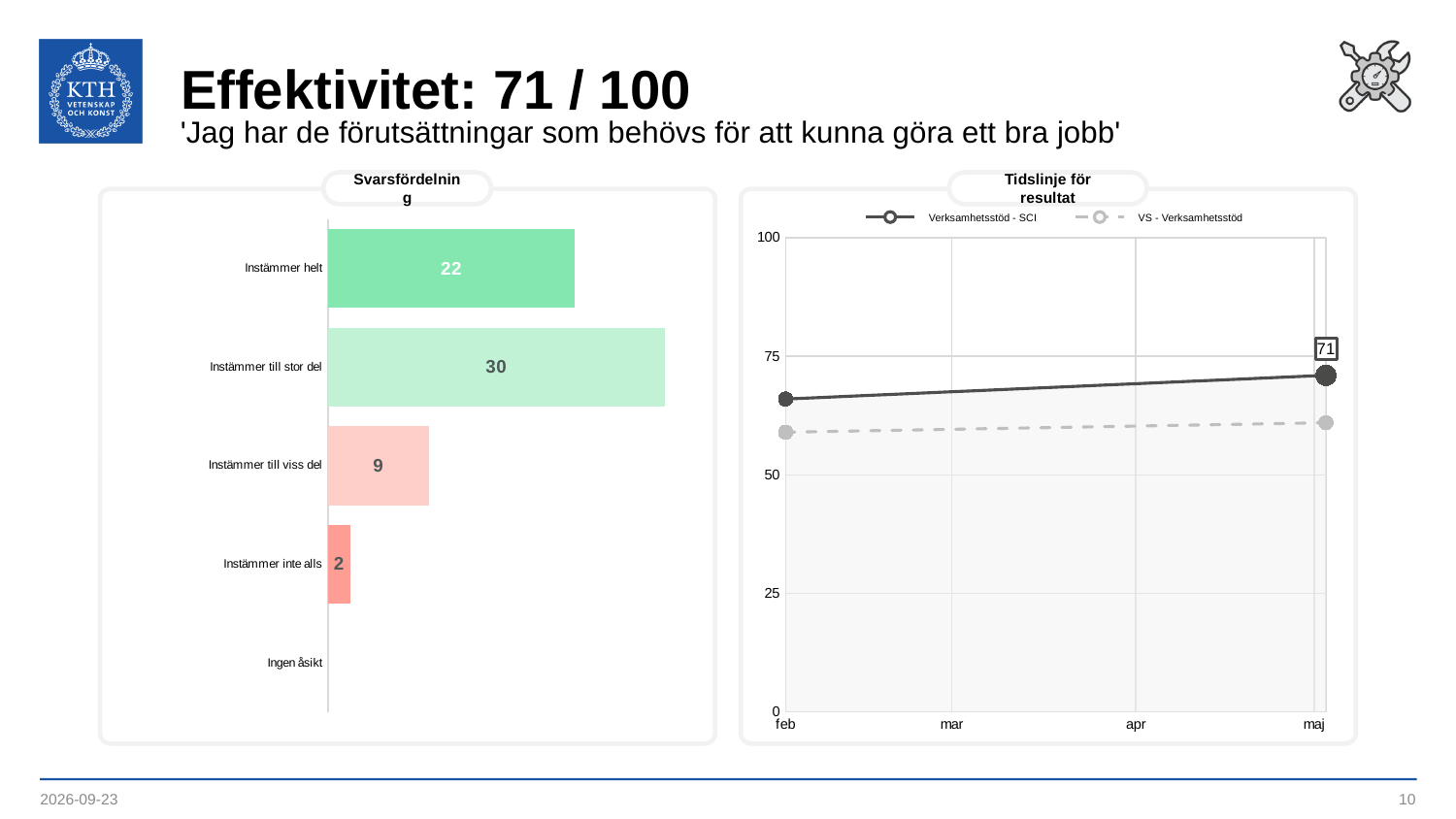
In the Svarsfördelning chart, what is the value for Instämmer helt? 22 In the Svarsfördelning chart, what is the difference between Instämmer till stor del and Instämmer helt? 8 In the Svarsfördelning chart, which category has the highest value? Instämmer till stor del In the Svarsfördelning chart, what is the value for Instämmer inte alls? 2 In the Tidslinje för resultat chart, is the value for Verksamhetsstöd - SCI in feb greater or less than 75? less In the Tidslinje för resultat chart, does the Verksamhetsstöd - SCI line rise or fall from feb to maj? rise In the Tidslinje för resultat chart, what is the value for Verksamhetsstöd - SCI in maj? 71 In the Tidslinje för resultat chart, how many series does the legend list? 2 What kind of chart is the Svarsfördelning chart? Bar chart In the Svarsfördelning chart, how many categories are shown on the axis? 5 In the Svarsfördelning chart, what is the value for Instämmer till stor del? 30 In the Svarsfördelning chart, which is larger: Instämmer till viss del or Instämmer inte alls? Instämmer till viss del